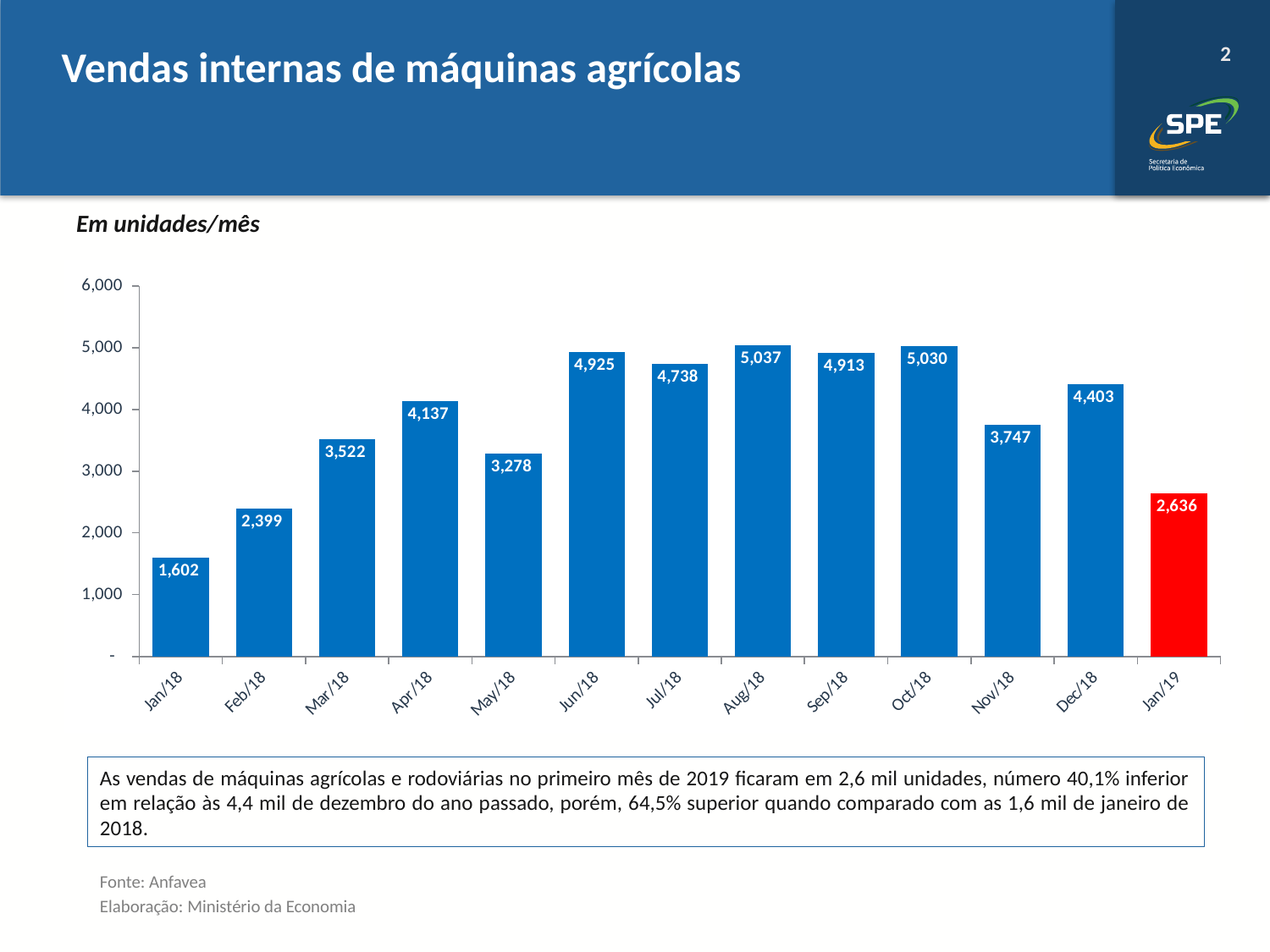
What type of chart is shown on the slide? Bar chart What is the value for Nov/18? 3,747 Which month has the highest value? Aug/18 What is the value for Jan/19? 2,636 What is the difference between the values for Jan/19 and Jan/18? 1,034 Is the value for Nov/18 greater or less than 4,000? less How many months are plotted on the chart? 13 Which bar is coloured red instead of blue? Jan/19 What is the difference between the values for Dec/18 and Jan/19? 1,767 What is the value for Jun/18? 4,925 Which is larger, the value for Mar/18 or the value for May/18? Mar/18 Which month has the lowest value? Jan/18